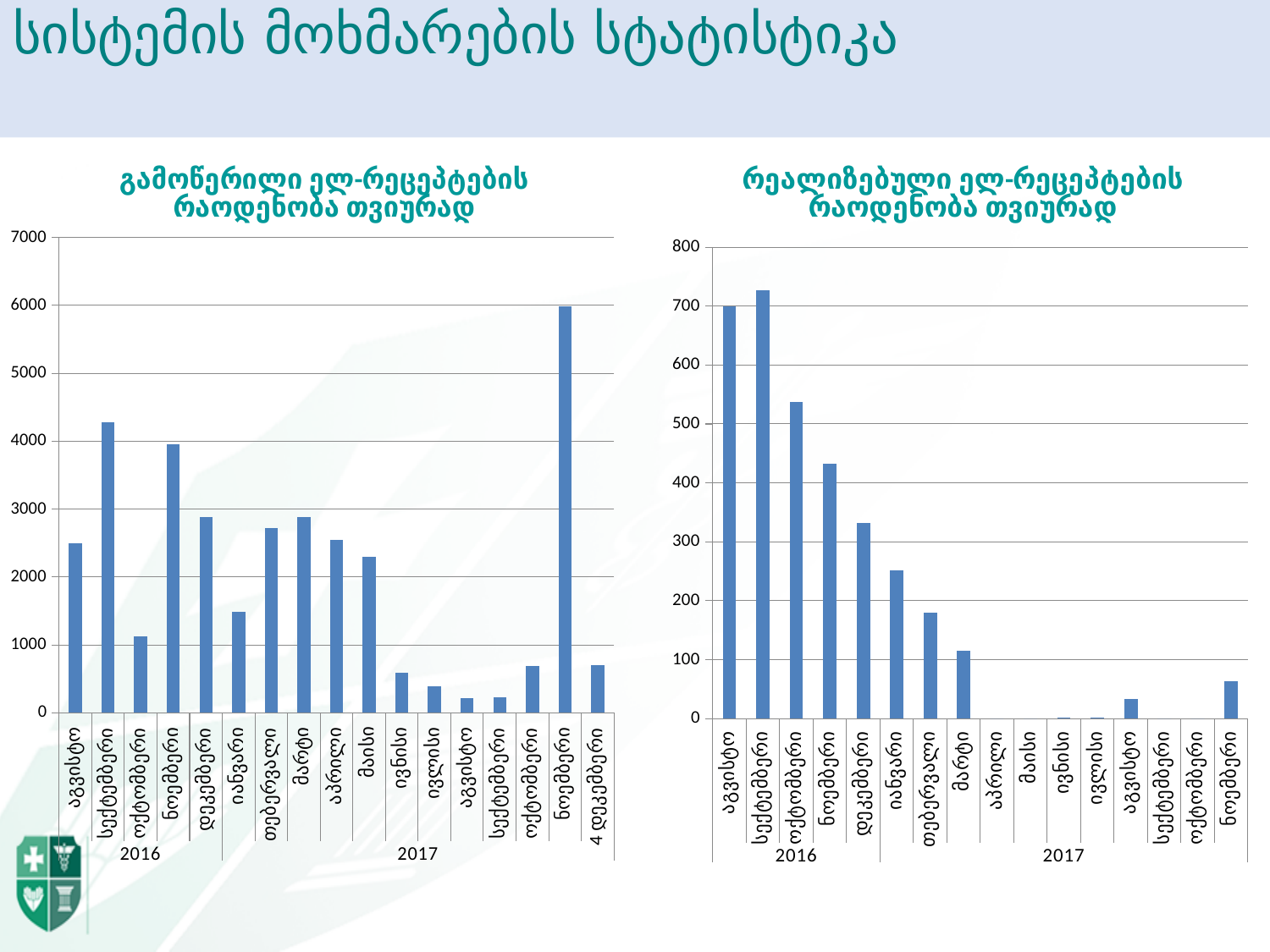
In the right chart, do the values rise or fall from სექტემბერი 2016 to მარტი 2017? fall In the right chart, is the value for თებერვალი 2017 greater or less than 200? less In the left chart, is the value for ნოემბერი 2017 greater or less than 5000? greater What kind of chart is the left chart titled "გამოწერილი ელ-რეცეპტების რაოდენობა თვიურად"? bar chart In the left chart (გამოწერილი ელ-რეცეპტების რაოდენობა თვიურად), which month has the highest value? ნოემბერი 2017 In the right chart, is the value for ოქტომბერი 2016 greater or less than 500? greater In the right chart (რეალიზებული ელ-რეცეპტების რაოდენობა თვიურად), which month has the highest value? სექტემბერი 2016 In the right chart, which is larger: the value for იანვარი 2017 or თებერვალი 2017? იანვარი 2017 How many months (bars) are shown on the x axis of the right chart? 16 In the left chart, which is larger: the value for ნოემბერი 2016 or დეკემბერი 2016? ნოემბერი 2016